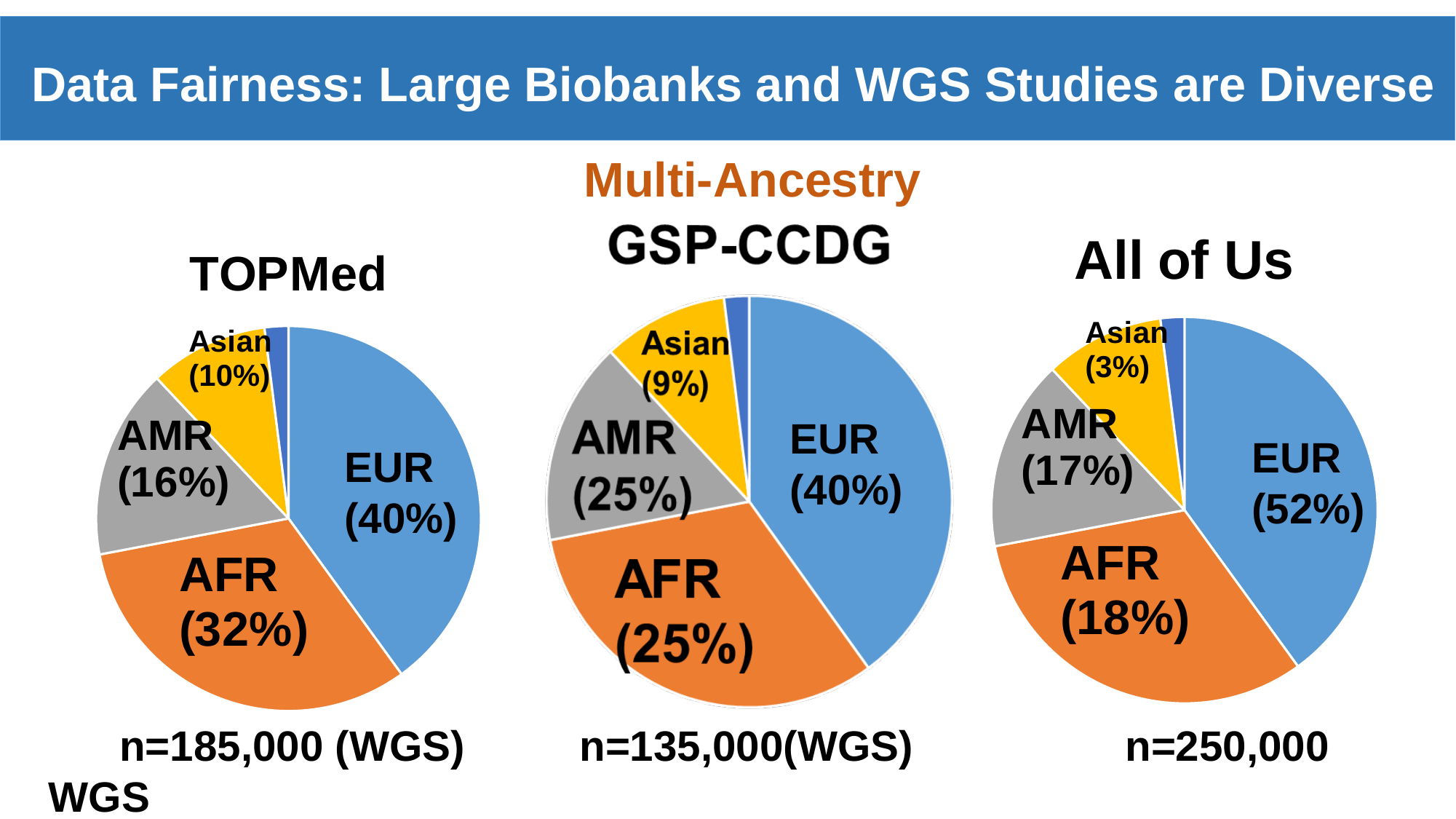
In the TOPMed pie chart, what share is labelled for EUR? 40% How many pie charts are shown on the slide? 3 In the GSP-CCDG pie chart, which labelled slice is the smallest? Asian In the All of Us pie chart, which labelled slice is the largest? EUR In the TOPMed pie chart, what share is labelled for AFR? 32% What sample size is printed below the All of Us pie chart? n=250,000 What type of chart is used for the TOPMed, GSP-CCDG and All of Us data? Pie chart In the All of Us pie chart, what share is labelled for Asian? 3% In the TOPMed pie chart, what is the difference between the EUR share and the AFR share? 8% Which is larger: the AMR share in the GSP-CCDG pie chart or the AMR share in the TOPMed pie chart? GSP-CCDG In the All of Us pie chart, what is the difference between the EUR share and the AFR share? 34%